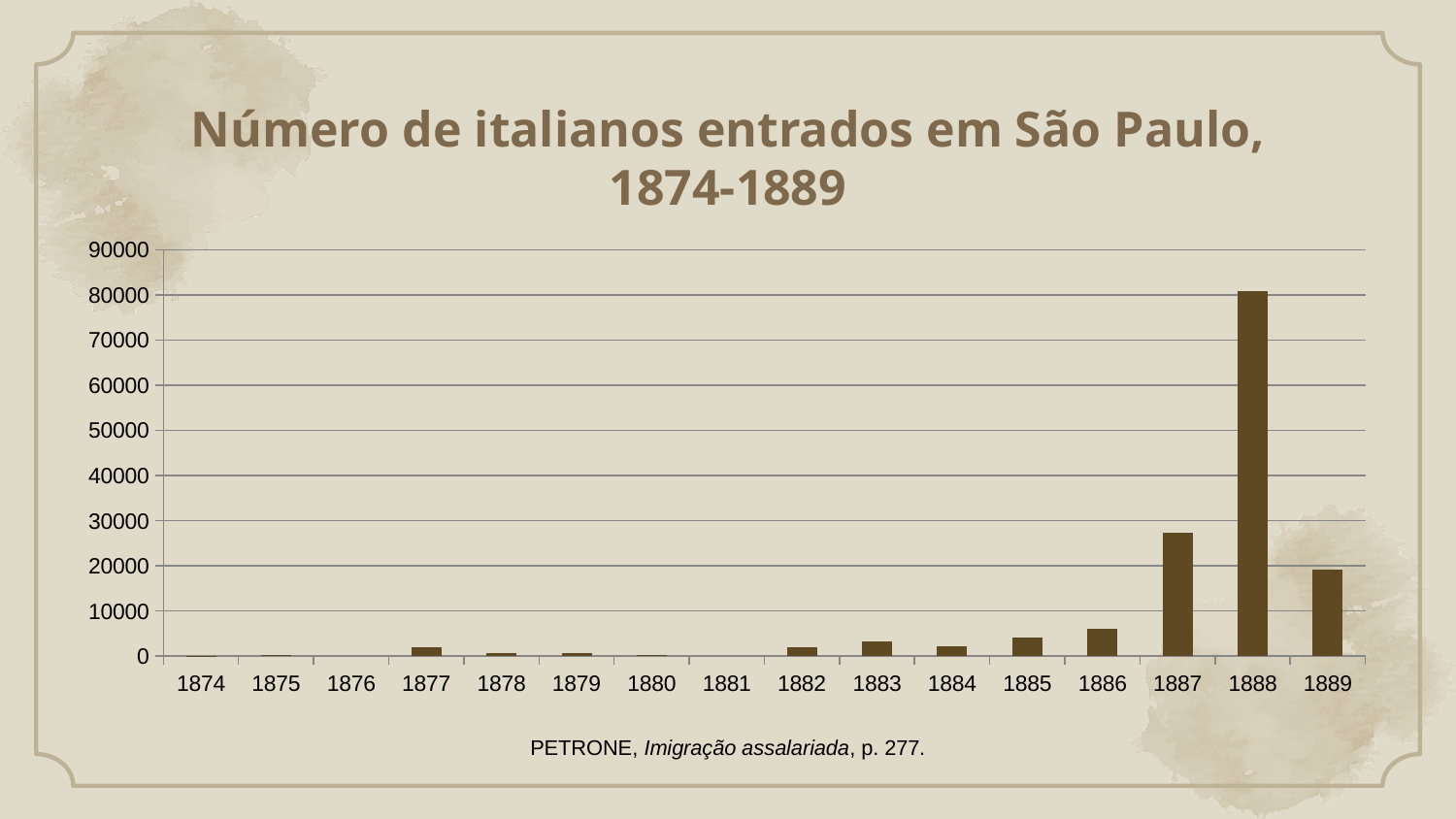
Is the value for 1889 greater or less than 10000? greater Which year has the larger value, 1886 or 1883? 1886 How many years are shown on the x axis of the chart? 16 Is the value for 1888 greater or less than 70000? greater Is the value for 1887 greater or less than 30000? less What is the title of the chart? Número de italianos entrados em São Paulo, 1874-1889 What kind of chart is shown on the slide? bar chart Do the values rise or fall from 1885 to 1888? rise Which year has the highest number of Italians entering São Paulo? 1888 Which year has the larger value, 1887 or 1889? 1887